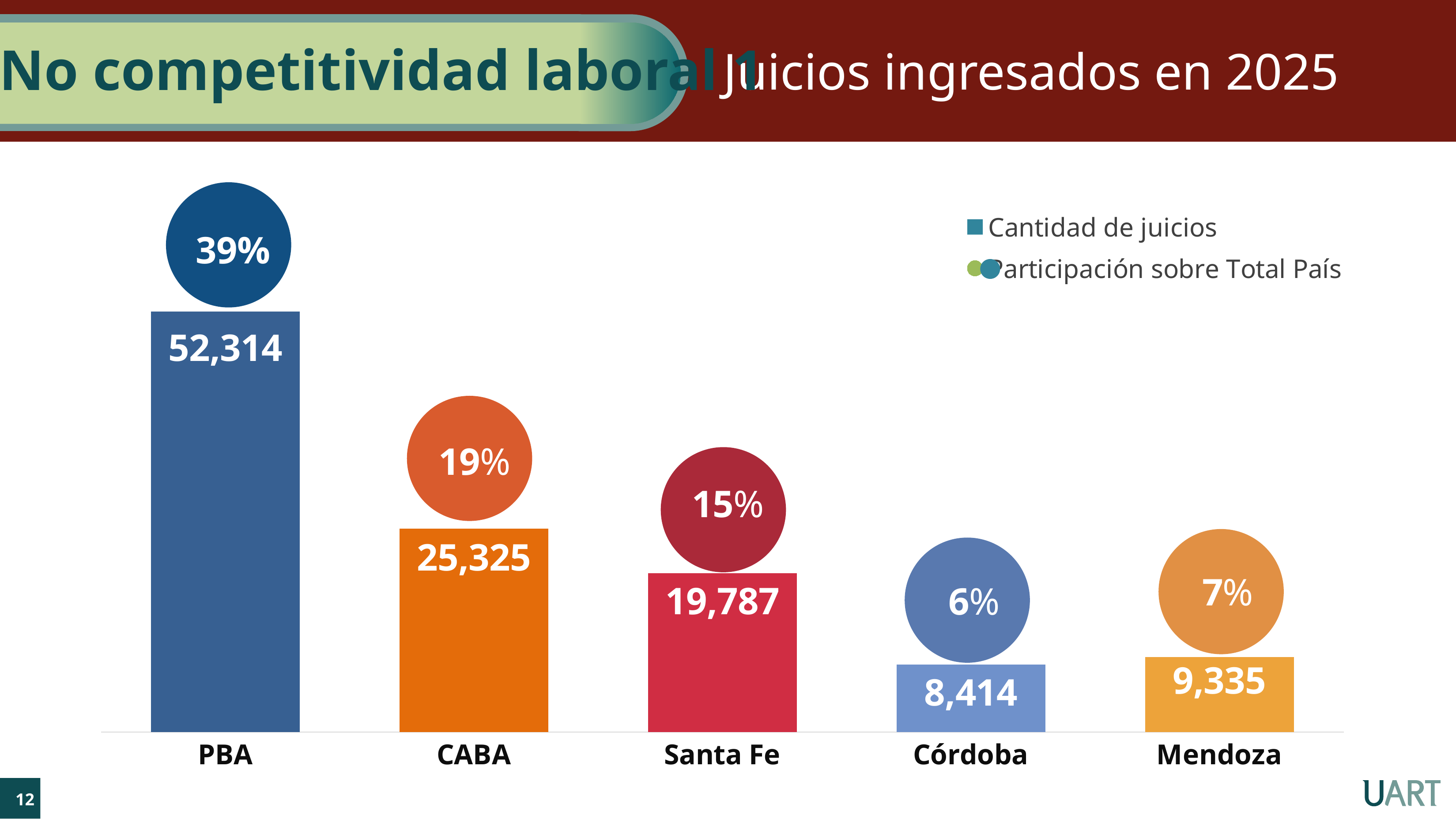
Which province has the lowest number of juicios? Córdoba What is the Participación sobre Total País for Mendoza? 7% Which has more juicios, Mendoza or Córdoba? Mendoza What is the number of juicios for Santa Fe? 19,787 How many provinces are shown on the x axis? 5 What is the difference in number of juicios between PBA and CABA? 26,989 What is the Participación sobre Total País for CABA? 19% How many series does the legend list? 2 What kind of chart is shown on the slide? Bar chart Which province has the highest number of juicios? PBA What is the difference in Participación sobre Total País between PBA and Santa Fe? 24% What is the number of juicios (Cantidad de juicios) for PBA? 52,314